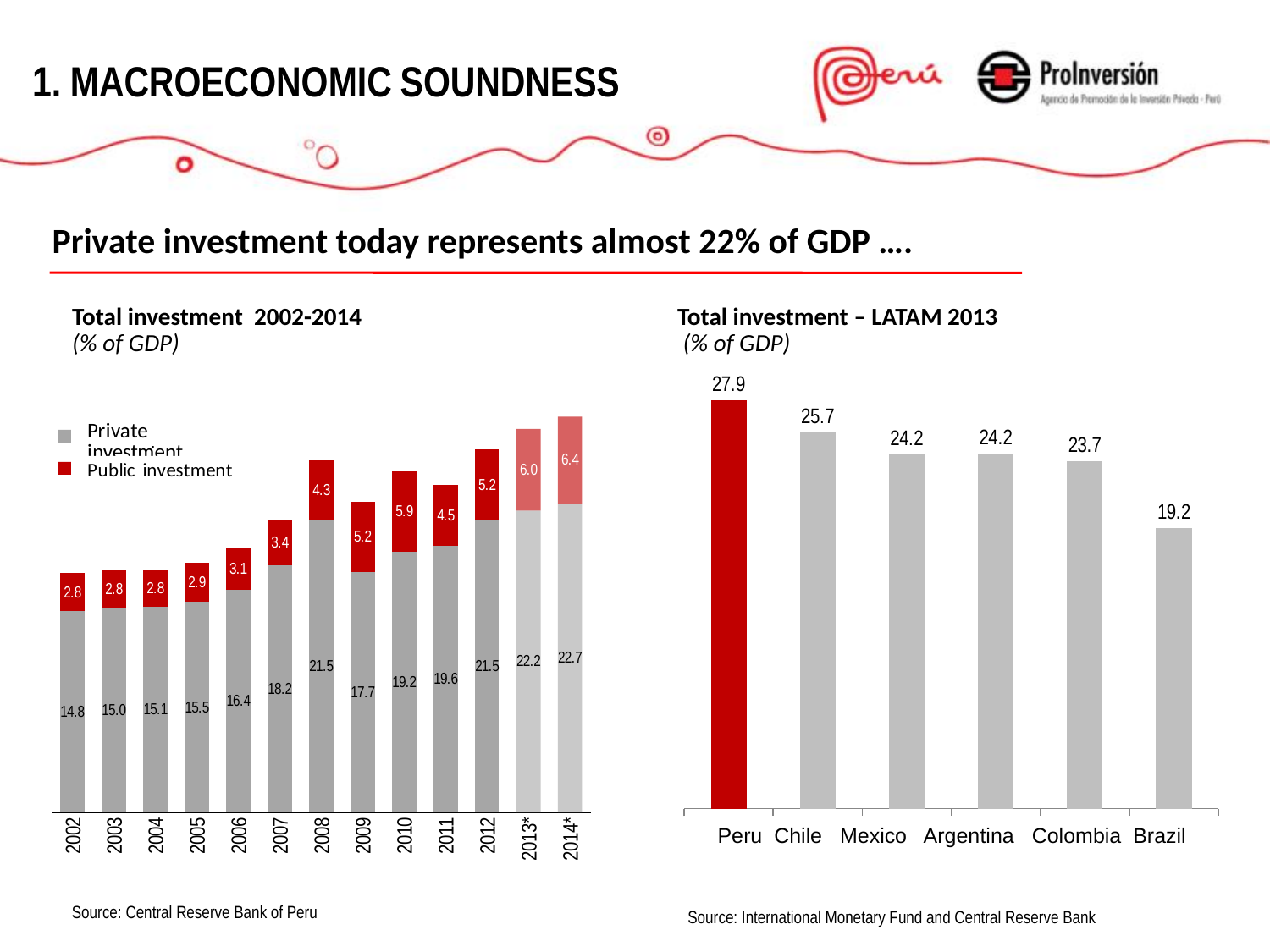
In the 'Total investment 2002-2014' chart, what is the private investment value for 2010? 19.2 In the 'Total investment – LATAM 2013' chart, which country has the lowest value? Brazil In the 'Total investment 2002-2014' chart, what is the public investment value for 2009? 5.2 In the 'Total investment 2002-2014' chart, which year has the lowest private investment value? 2002 In the 'Total investment 2002-2014' chart, what is the difference between private investment in 2012 and in 2009? 3.8 In the 'Total investment 2002-2014' chart, what is the total of the stacked bar for 2014*? 29.1 In the 'Total investment – LATAM 2013' chart, what is the difference between Peru and Chile? 2.2 In the 'Total investment 2002-2014' chart, how many series does the legend list? 2 In the 'Total investment 2002-2014' chart, which year has the highest public investment value? 2014* In the 'Total investment 2002-2014' chart, how many years are shown on the x axis? 13 In the 'Total investment – LATAM 2013' chart, what is the value for Colombia? 23.7 What kind of chart is the 'Total investment – LATAM 2013' chart? Bar chart